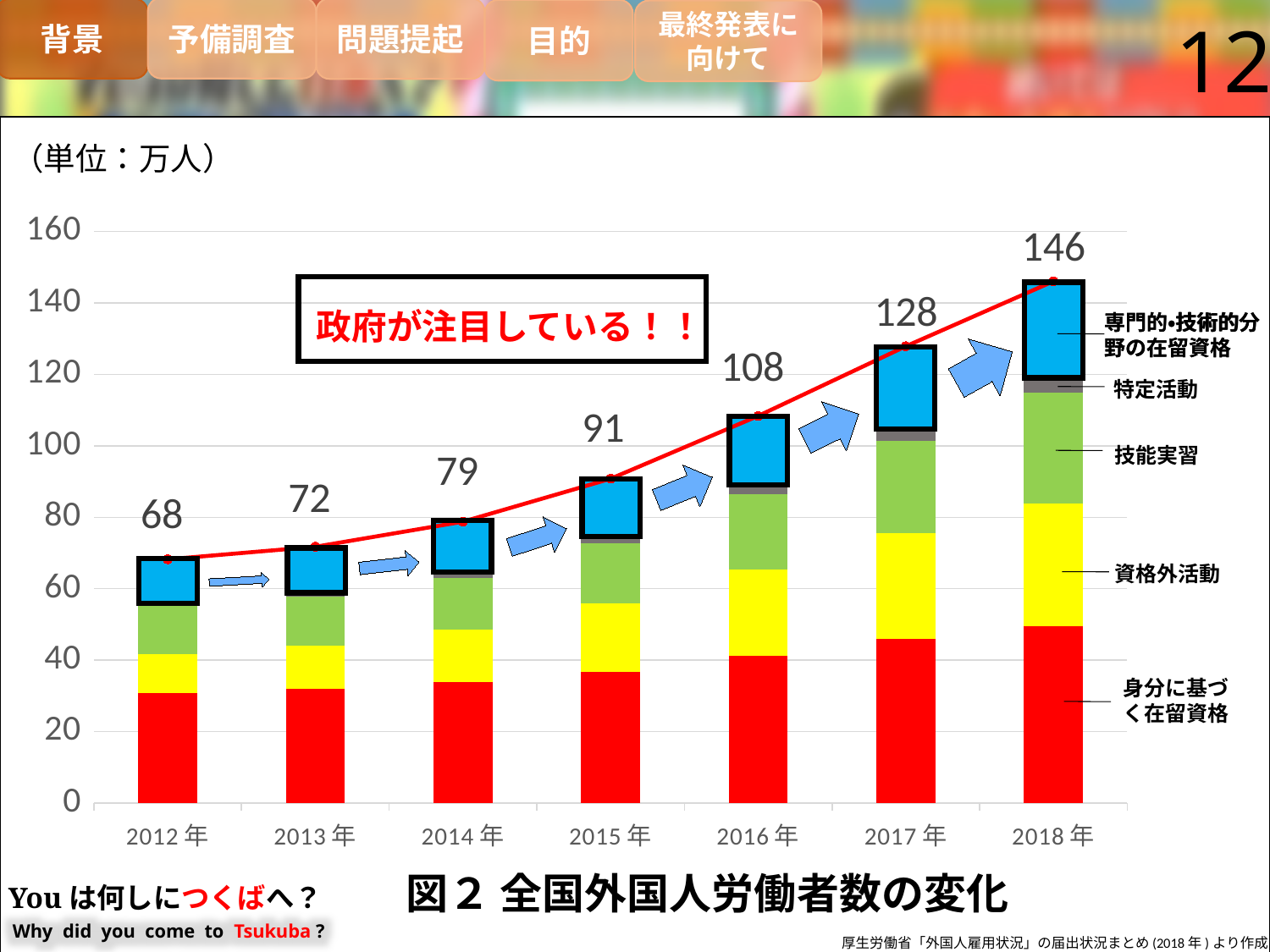
What is the total value labeled for 2015年? 91 Which year has the lowest total number of foreign workers? 2012年 How many years are shown on the x axis? 7 What is the difference between the totals for 2016年 and 2012年? 40 What is the total value labeled for 2012年? 68 What is the difference between the totals for 2018年 and 2017年? 18 Which year has the highest total number of foreign workers? 2018年 Do the total values rise or fall from 2012年 to 2018年? rise How many series (residence status categories) are shown in the stacked bars? 5 Which is larger, the total for 2014年 or the total for 2016年? 2016年 What is the total number of foreign workers shown for 2018年? 146 Is the value of the 身分に基づく在留資格 segment for 2018年 greater or less than 60? less